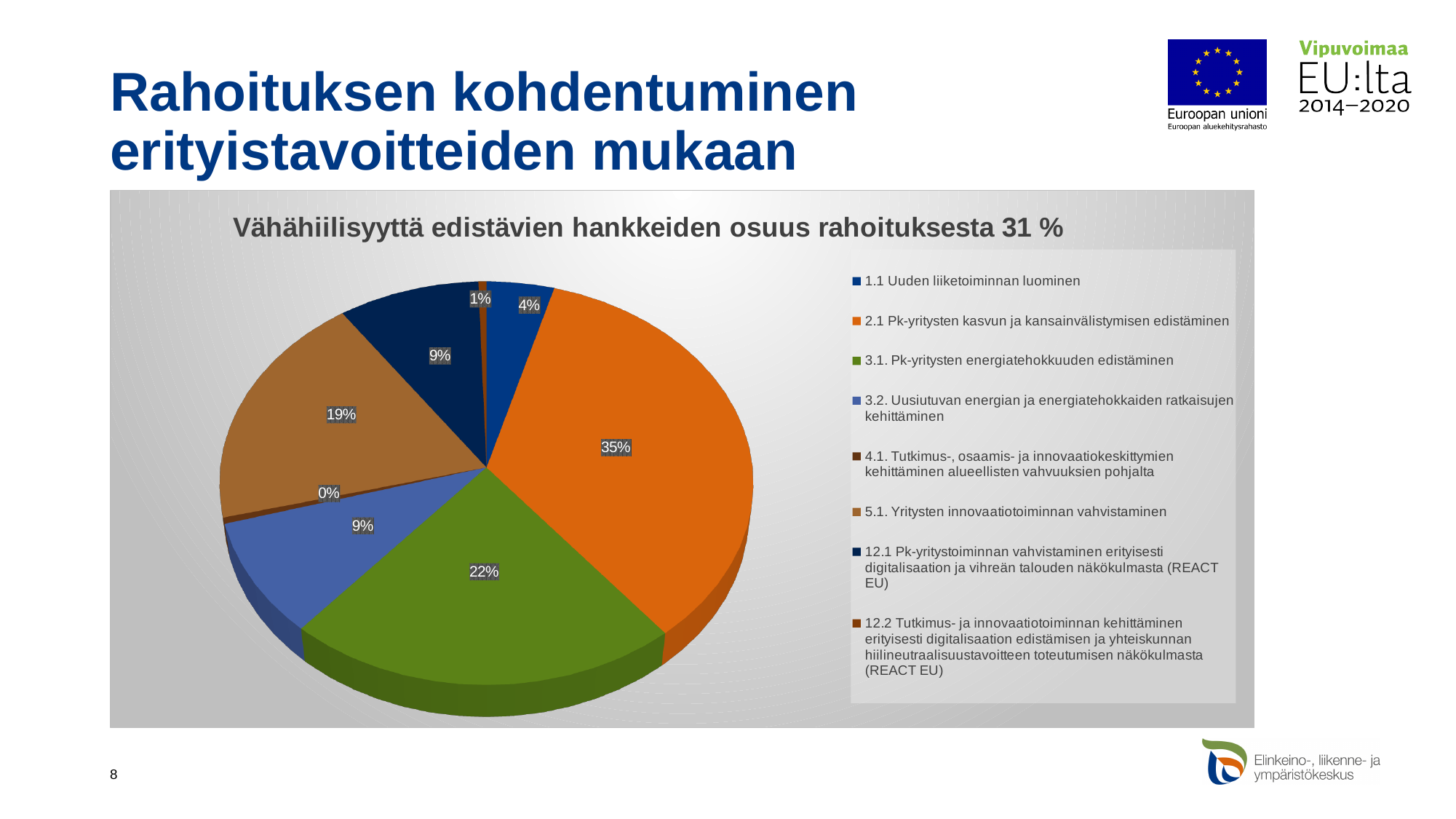
Which category has the largest share of the pie? 2.1 Pk-yritysten kasvun ja kansainvälistymisen edistäminen What share of the funding goes to 3.1. Pk-yritysten energiatehokkuuden edistäminen? 22% Which category has the smallest share of the pie? 4.1. Tutkimus-, osaamis- ja innovaatiokeskittymien kehittäminen alueellisten vahvuuksien pohjalta Which has a larger share: 5.1. Yritysten innovaatiotoiminnan vahvistaminen or 3.2. Uusiutuvan energian ja energiatehokkaiden ratkaisujen kehittäminen? 5.1. Yritysten innovaatiotoiminnan vahvistaminen What share of the funding goes to 1.1 Uuden liiketoiminnan luominen? 4% What percentage is shown for 4.1. Tutkimus-, osaamis- ja innovaatiokeskittymien kehittäminen alueellisten vahvuuksien pohjalta? 0% How many categories does the legend of the pie chart list? 8 What is the difference in percentage points between the share for 2.1 Pk-yritysten kasvun ja kansainvälistymisen edistäminen and the share for 3.1. Pk-yritysten energiatehokkuuden edistäminen? 13 percentage points What kind of chart is shown on the slide? pie chart What share of the funding goes to 2.1 Pk-yritysten kasvun ja kansainvälistymisen edistäminen? 35% What is the title of the chart? Vähähiilisyyttä edistävien hankkeiden osuus rahoituksesta 31 %